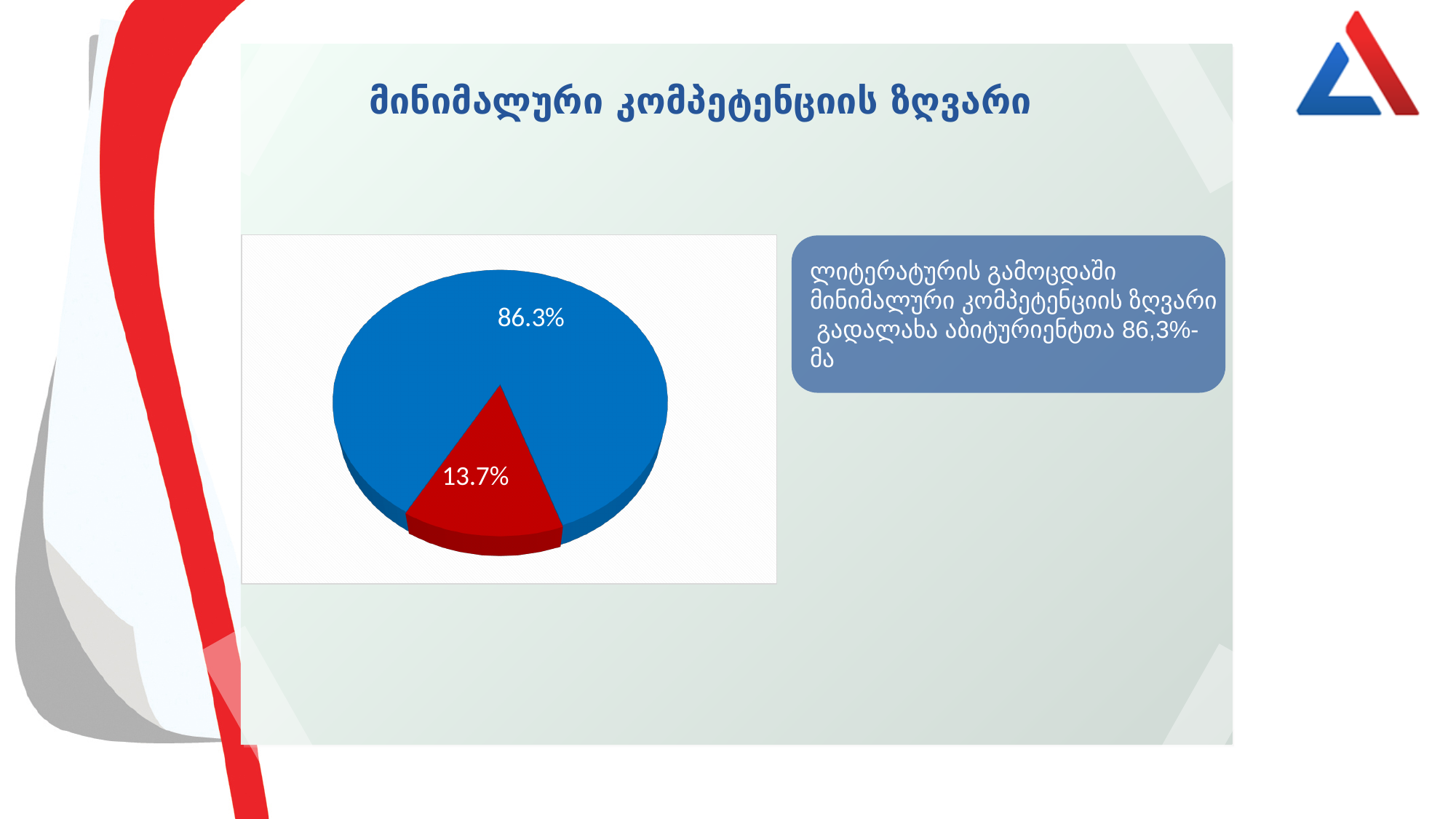
What share of the pie does the red slice represent? 13.7% What is the difference in percentage points between the blue slice and the red slice of the pie chart? 72.6 What is the total of the two slice values shown on the pie chart? 100% Which slice of the pie chart is the largest? the blue slice (86.3%) Does the pie chart display a legend? No What value is labelled on the red slice of the pie chart? 13.7% How many slices does the pie chart have? 2 Which slice of the pie chart is the smallest? the red slice (13.7%) What value is labelled on the blue slice of the pie chart? 86.3% What kind of chart is shown on the slide? pie chart What colour is the slice labelled 86.3% in the pie chart? blue Which is larger in the pie chart, the blue slice or the red slice? the blue slice